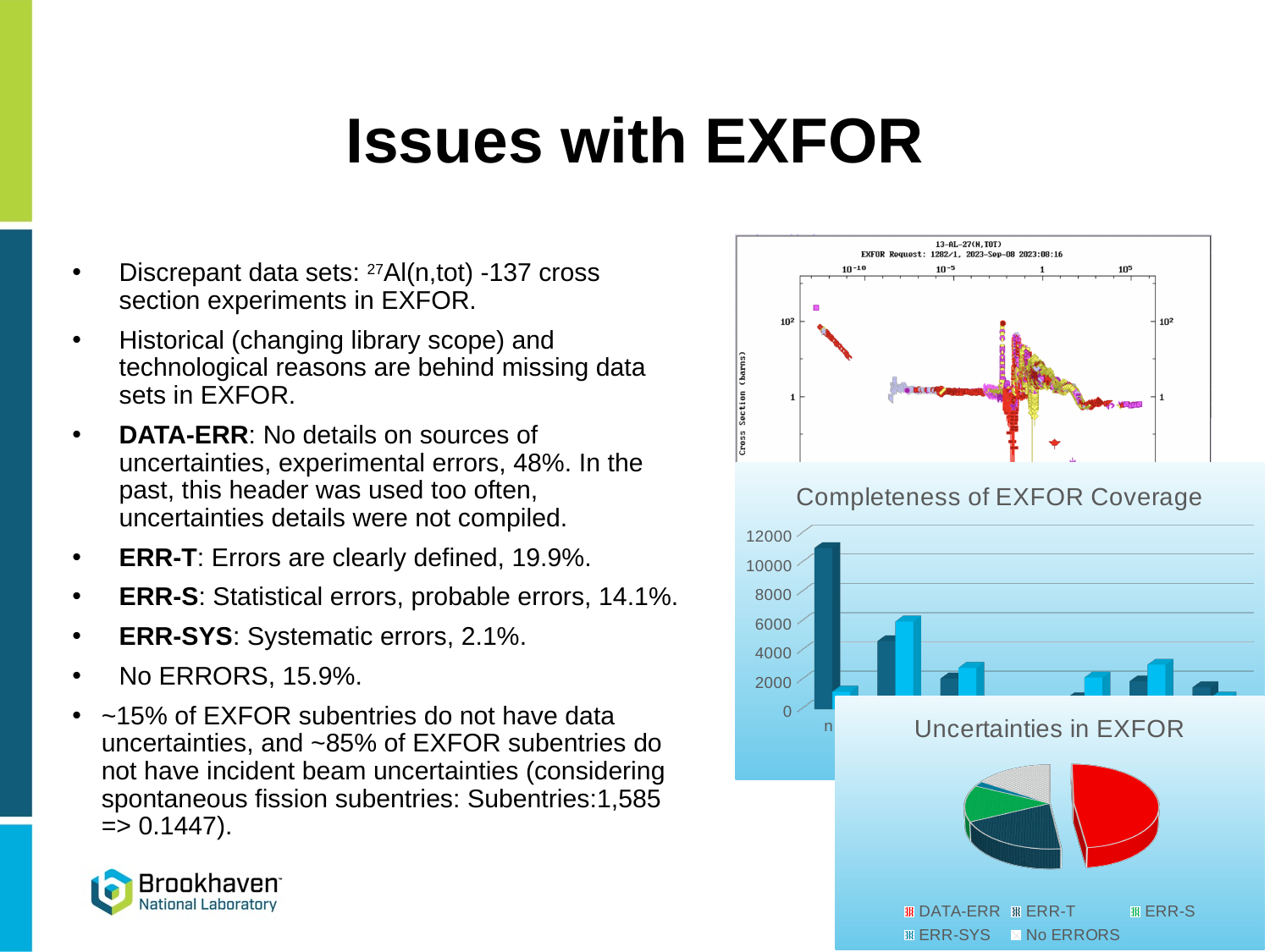
In the Completeness of EXFOR Coverage chart, what is the highest value shown on the vertical axis? 12000 What kind of chart is the Completeness of EXFOR Coverage chart? bar chart In the Uncertainties in EXFOR chart, how many entries does the legend list? 5 In the Uncertainties in EXFOR chart, which slice is larger, DATA-ERR or ERR-SYS? DATA-ERR In the Uncertainties in EXFOR chart, which category has the smallest slice? ERR-SYS In the Completeness of EXFOR Coverage chart, is the value of the tallest bar greater or less than 10000? greater In the Uncertainties in EXFOR chart, which category has the largest slice? DATA-ERR What kind of chart is the Uncertainties in EXFOR chart? pie chart In the chart at the top right of the slide, what is the label on the vertical axis? Cross Section (barns)